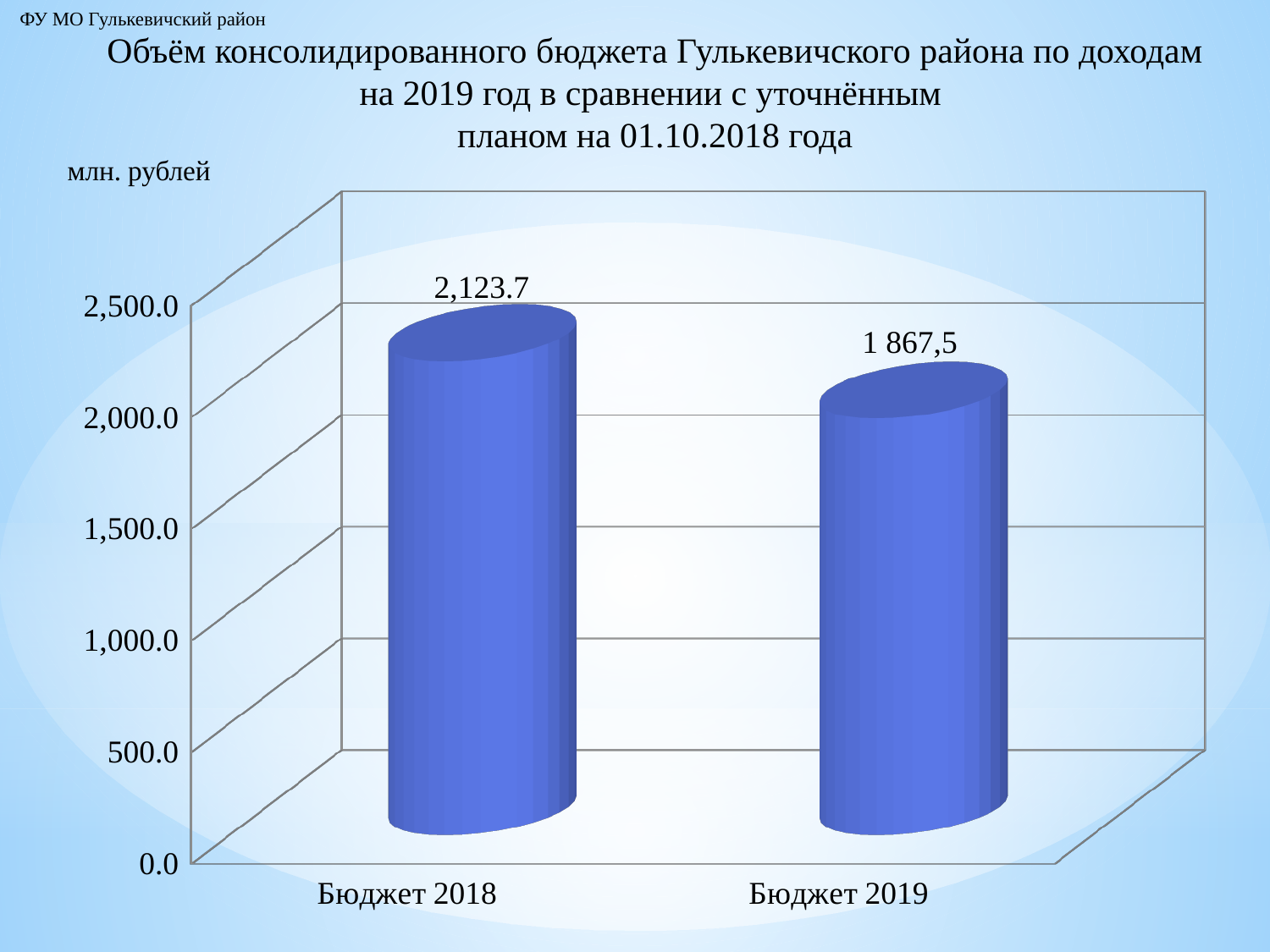
What is the value for Бюджет 2018? 2,123.7 Which is larger, the value for Бюджет 2018 or the value for Бюджет 2019? Бюджет 2018 Is the value for Бюджет 2019 greater or less than 2,000.0? less Is the value for Бюджет 2018 greater or less than 2,000.0? greater How many categories are shown on the chart? 2 Do the values rise or fall from Бюджет 2018 to Бюджет 2019? fall What is the value for Бюджет 2019? 1 867,5 What unit is shown for the values on the chart? млн. рублей Which category has the highest value? Бюджет 2018 What kind of chart is shown on the slide? bar chart Which category has the lowest value? Бюджет 2019 What is the difference between the values for Бюджет 2018 and Бюджет 2019? 256.2